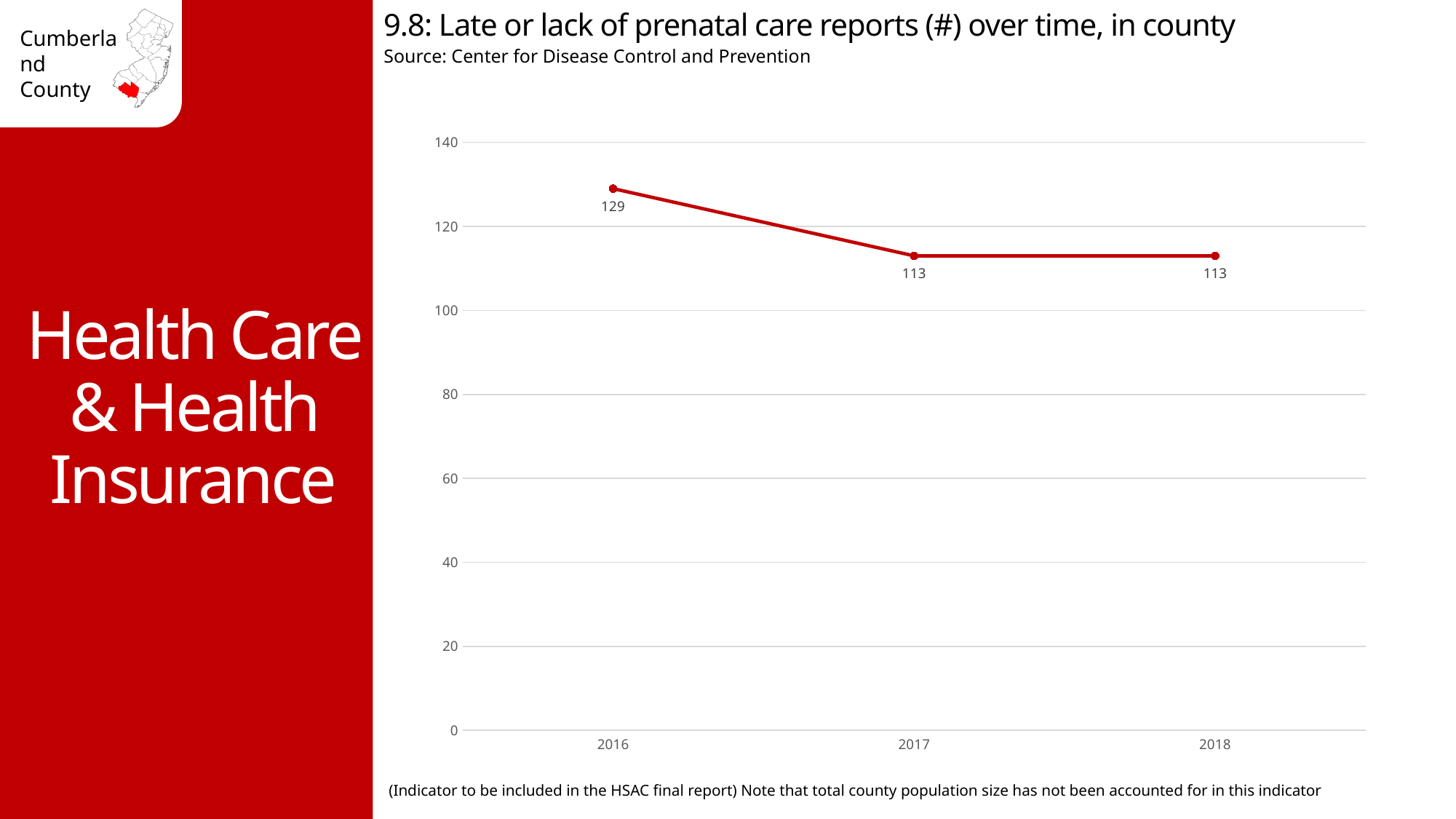
Is the value for 2016 greater or less than 120? greater How many years are plotted on the chart? 3 Do the values rise or fall from 2016 to 2017? fall What kind of chart is shown on the slide? line chart What is the value for 2016? 129 What is the value for 2017? 113 Is the value for 2017 greater or less than 120? less Which year has the highest number of late or lack of prenatal care reports? 2016 What is the difference between the values for 2016 and 2017? 16 What is the source cited for the chart? Center for Disease Control and Prevention What is the value for 2018? 113 Which is larger, the value for 2016 or the value for 2018? 2016